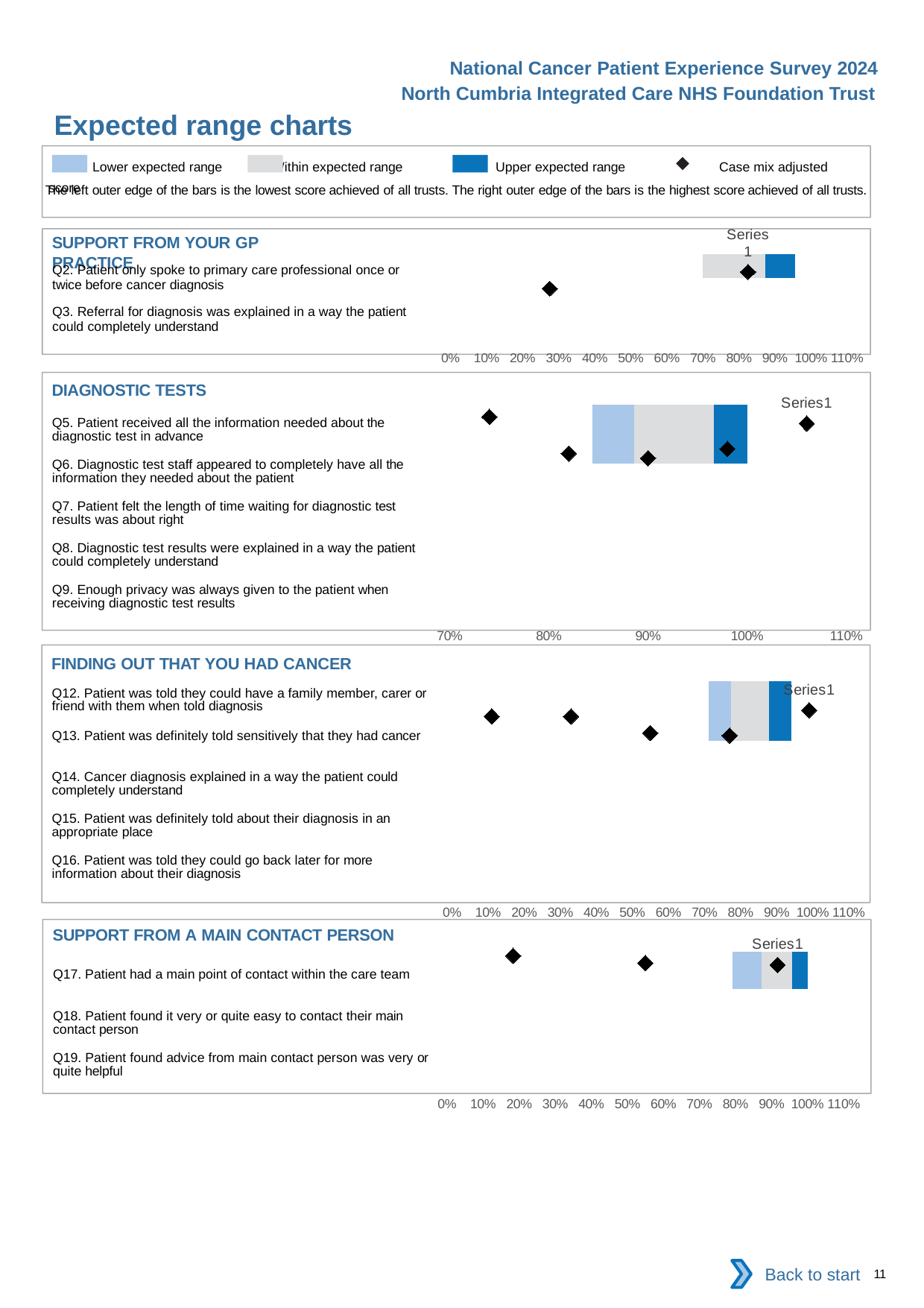
How many questions are listed in the DIAGNOSTIC TESTS chart? 5 What kind of chart is used in the DIAGNOSTIC TESTS section? bar chart How many questions are listed in the SUPPORT FROM YOUR GP PRACTICE chart? 2 How many questions are listed in the FINDING OUT THAT YOU HAD CANCER chart? 5 How many entries does the legend at the top of the slide list? 4 What is the lowest value shown on the x axis of the DIAGNOSTIC TESTS chart? 70% According to the legend, what does the black diamond marker represent? Case mix adjusted score In the SUPPORT FROM A MAIN CONTACT PERSON chart, is the diamond marker inside the shaded bar greater or less than 80%? greater In the SUPPORT FROM A MAIN CONTACT PERSON chart, is the leftmost diamond marker greater or less than 30%? less In the FINDING OUT THAT YOU HAD CANCER chart, is the leftmost diamond marker greater or less than 20%? less